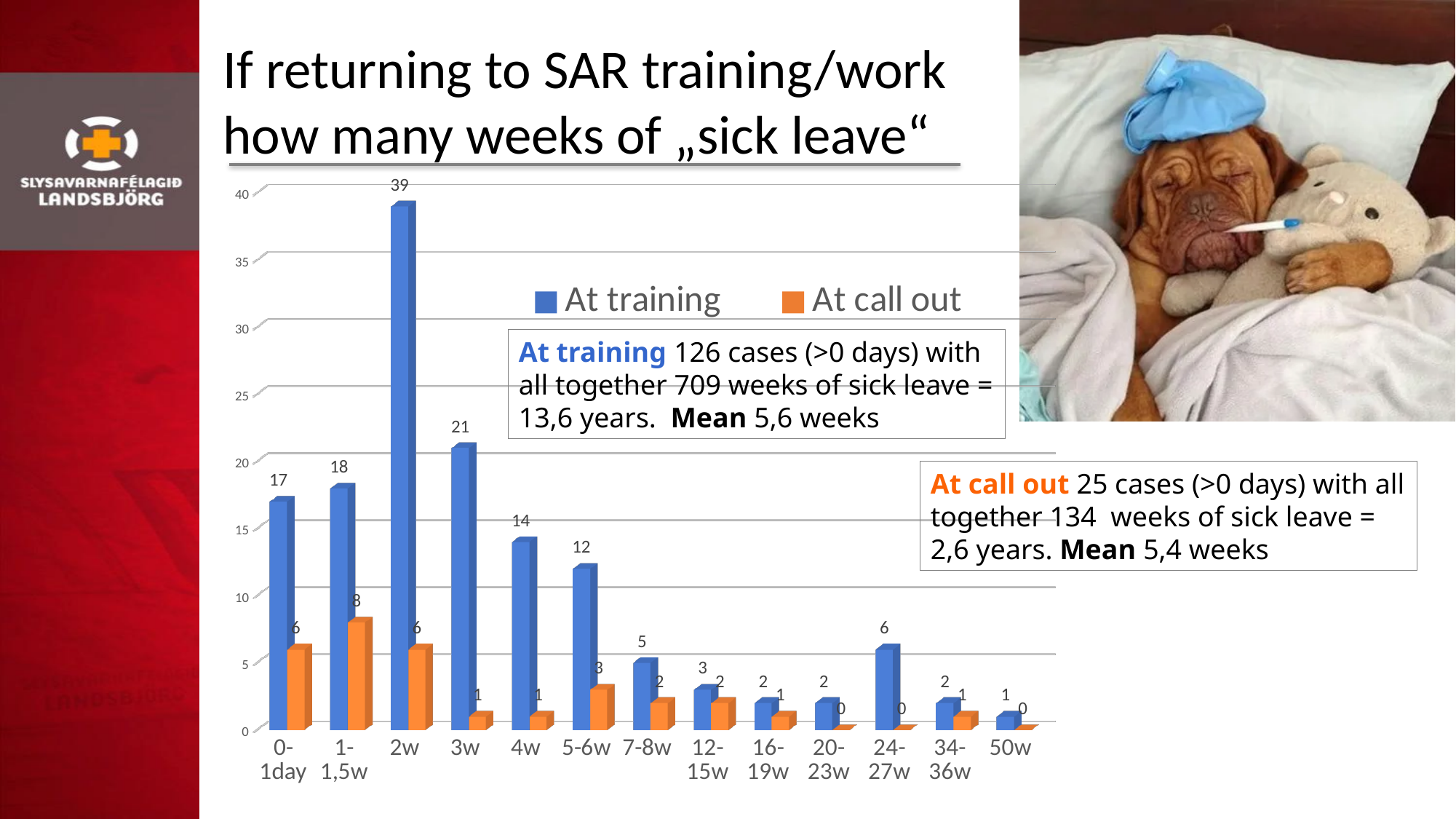
Which is larger: the At training value for 4w or the At training value for 5-6w? 4w Which category has the highest At call out value? 1-1,5w What is the value for At training in the 3w category? 21 What kind of chart is shown on the slide? bar chart How many categories are shown on the x axis? 13 How many series does the legend list? 2 What are the two series named in the legend? At training and At call out What is the difference between the At training and At call out values in the 2w category? 33 Which category has the highest At training value? 2w What is the value for At training in the 2w category? 39 What is the value for At call out in the 1-1,5w category? 8 What is the value for At call out in the 5-6w category? 3